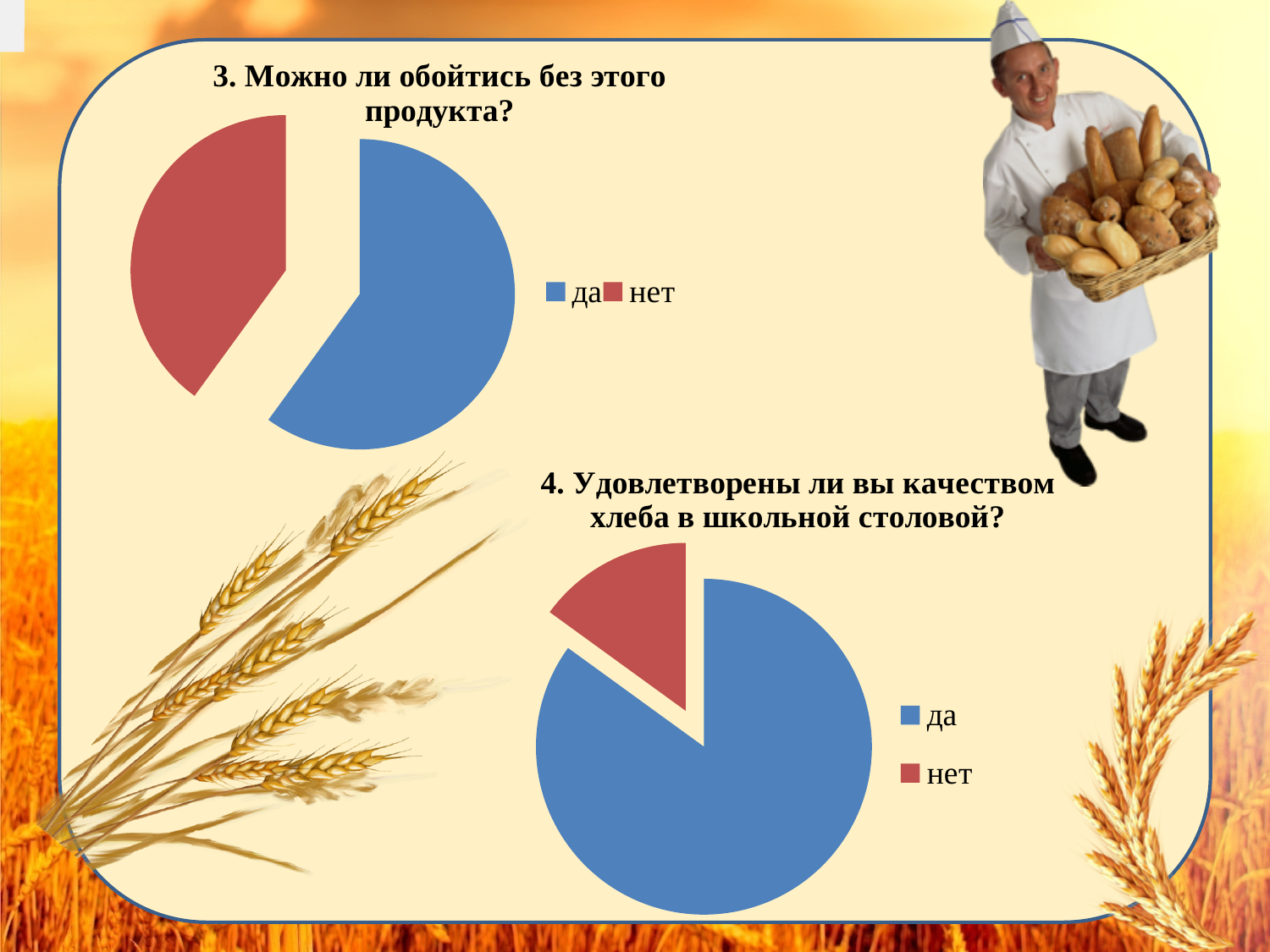
What is the title of the pie chart in the lower part of the slide? 4. Удовлетворены ли вы качеством хлеба в школьной столовой? In the pie chart for question 4, what colour is the slice for "нет"? red In the pie chart for question 3 ("Можно ли обойтись без этого продукта?"), which answer has the largest slice? да What kind of chart is used for question 4, "Удовлетворены ли вы качеством хлеба в школьной столовой?"? pie chart How many slices does the pie chart for question 3 have? 2 In the pie chart for question 4, is the slice for "нет" larger or smaller than the slice for "да"? smaller In the pie chart for question 3, is the slice for "да" larger or smaller than the slice for "нет"? larger In the pie chart for question 4 ("Удовлетворены ли вы качеством хлеба в школьной столовой?"), which answer has the smallest slice? нет In the pie chart for question 3 ("Можно ли обойтись без этого продукта?"), which answer has the smallest slice? нет In the pie chart for question 4 ("Удовлетворены ли вы качеством хлеба в школьной столовой?"), which answer has the largest slice? да How many entries does the legend of the pie chart for question 4 list? 2 What kind of chart is used for question 3, "Можно ли обойтись без этого продукта?"? pie chart